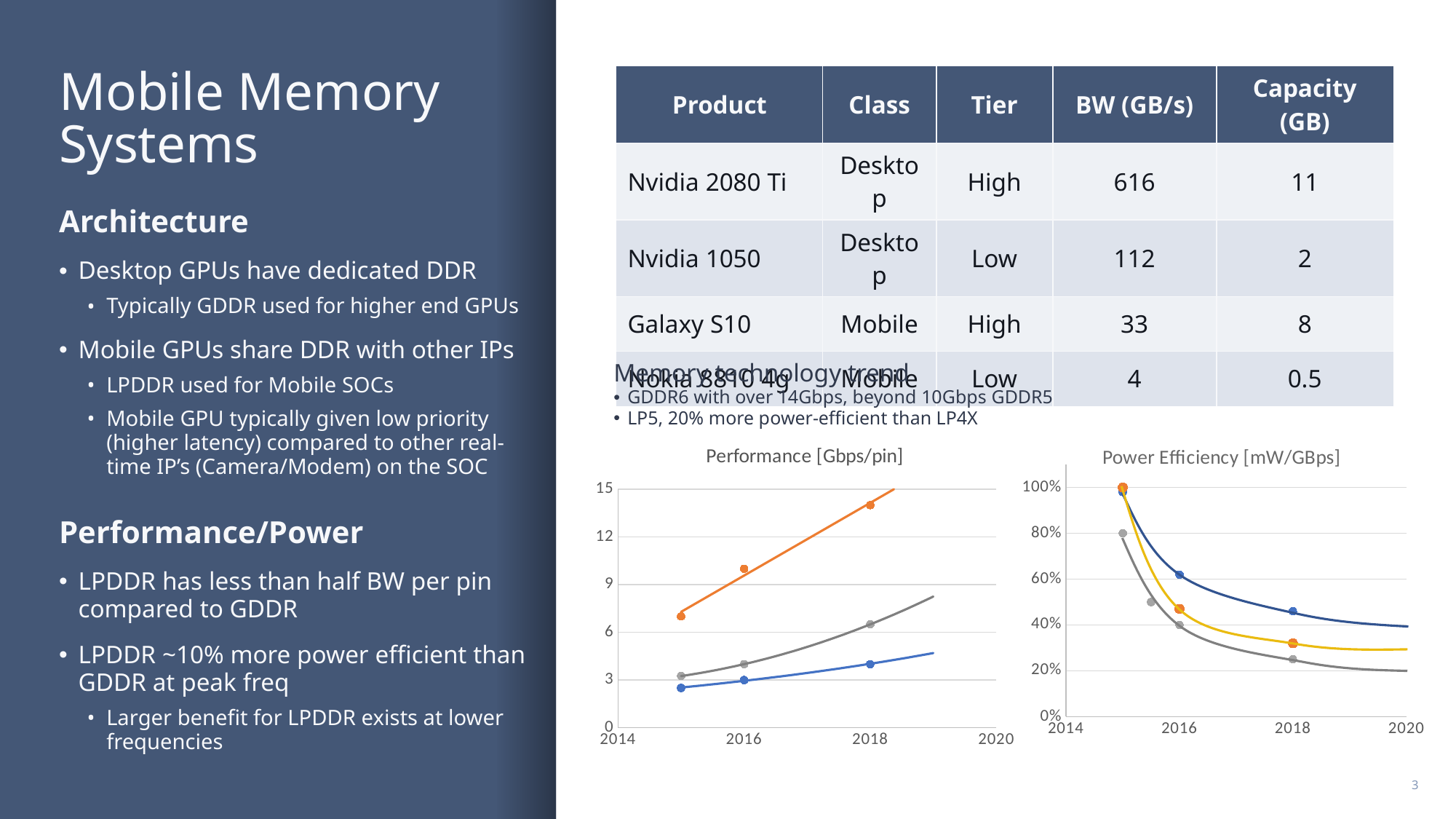
In the Power Efficiency [mW/GBps] chart, is the gray series value for 2018 greater or less than 40%? less In the Performance [Gbps/pin] chart, do the values rise or fall from 2015 to 2018? rise What is the title of the chart on the right side of the slide? Power Efficiency [mW/GBps] In the Power Efficiency [mW/GBps] chart, is the blue series value for 2018 greater or less than 40%? greater In the Performance [Gbps/pin] chart, which series has the highest value in 2018, the orange or the blue one? orange In the Power Efficiency [mW/GBps] chart, do the values rise or fall from 2015 to 2018? fall How many lines are plotted in the Performance [Gbps/pin] chart? 3 In the Performance [Gbps/pin] chart, is the blue series value for 2018 greater or less than 6? less How many lines are plotted in the Power Efficiency [mW/GBps] chart? 3 What kind of chart is the Performance [Gbps/pin] chart? line chart